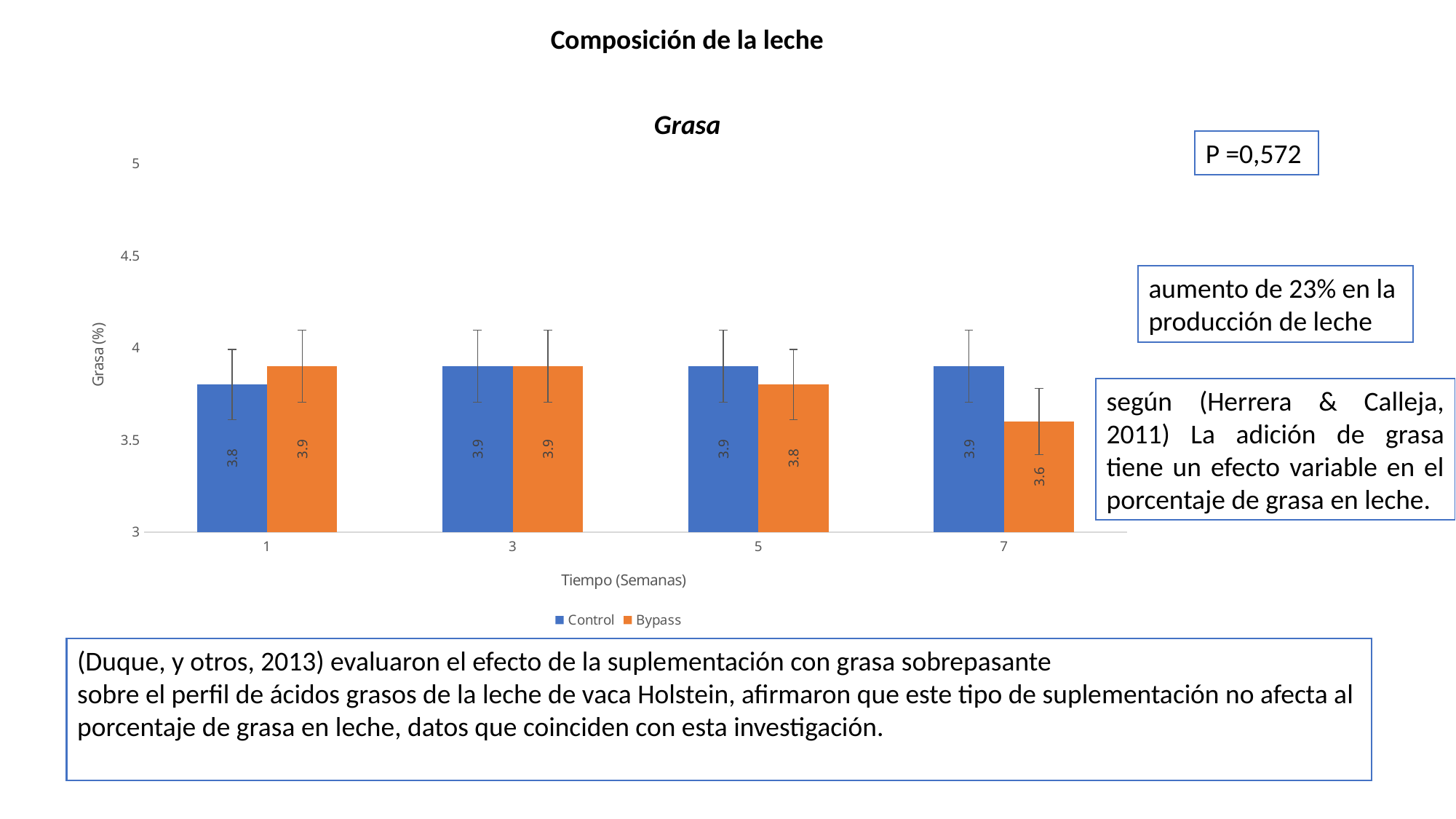
What is the Control value at week 1? 3.8 What is the difference between the Control and Bypass values at week 7? 0.3 How many weeks (categories) are shown on the x axis? 4 What kind of chart is shown? bar chart What is the Bypass value at week 7? 3.6 What is the Control value at week 3? 3.9 What is the Bypass value at week 5? 3.8 What is the label of the y axis? Grasa (%) Is the Bypass value at week 7 greater or less than 4? less How many series does the legend list? 2 At week 1, which series has the larger value, Control or Bypass? Bypass At which week is the Bypass value lowest? 7